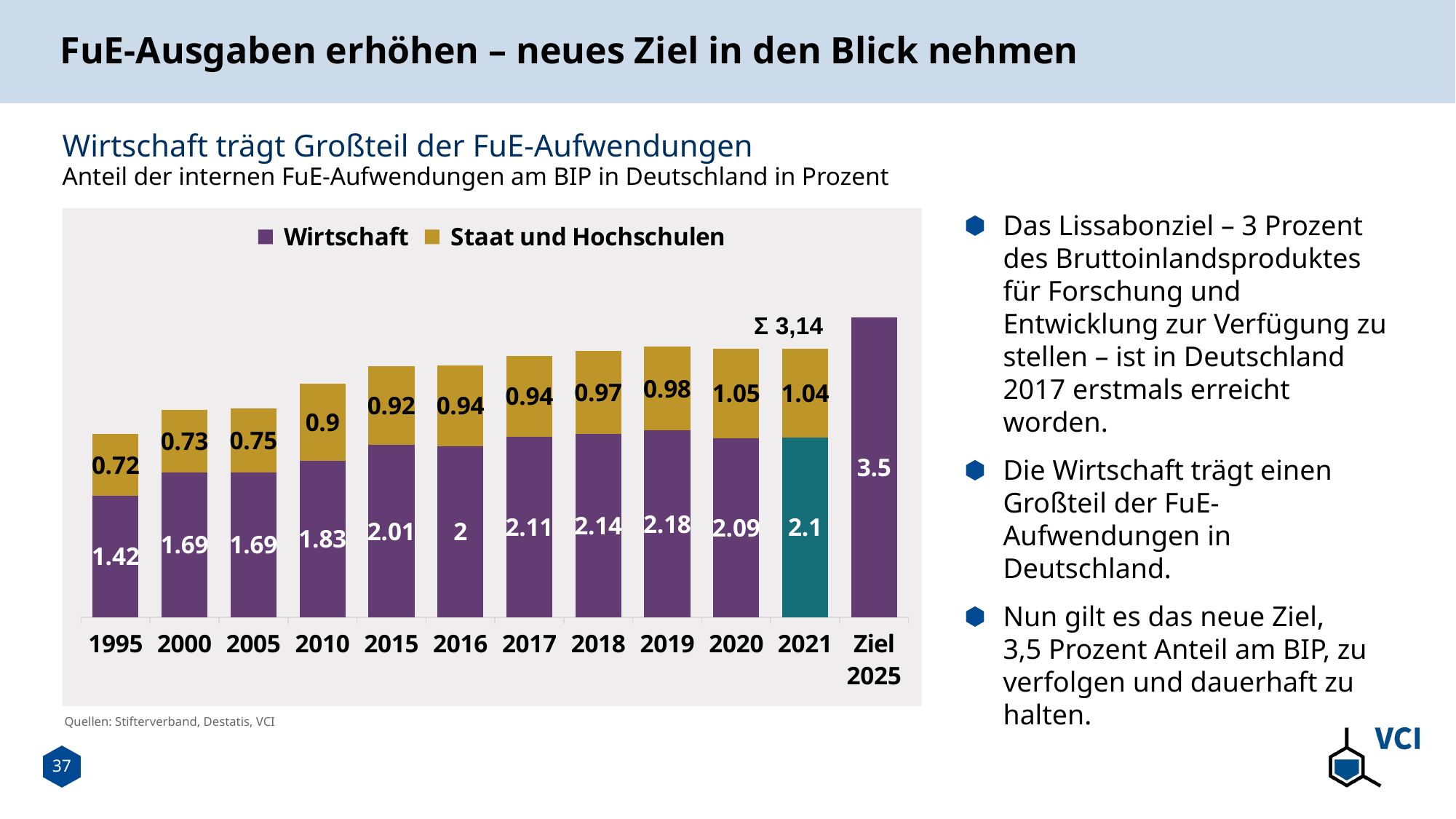
What is the value shown for the Ziel 2025 bar? 3.5 What is the Wirtschaft value for 1995? 1.42 Which year has the lowest Staat und Hochschulen value? 1995 How many series does the legend list? 2 What is the total of the stacked bar for 1995? 2.14 What is the Staat und Hochschulen value for 2020? 1.05 What total is printed above the 2021 bar? Σ 3,14 What kind of chart is shown on the slide? Stacked bar chart How many categories are shown on the x axis? 12 What is the difference between the Wirtschaft values for 2019 and 1995? 0.76 Which is larger, the Staat und Hochschulen value for 2020 or for 2021? 2020 Which year has the highest Wirtschaft value among the years 1995 to 2021? 2019